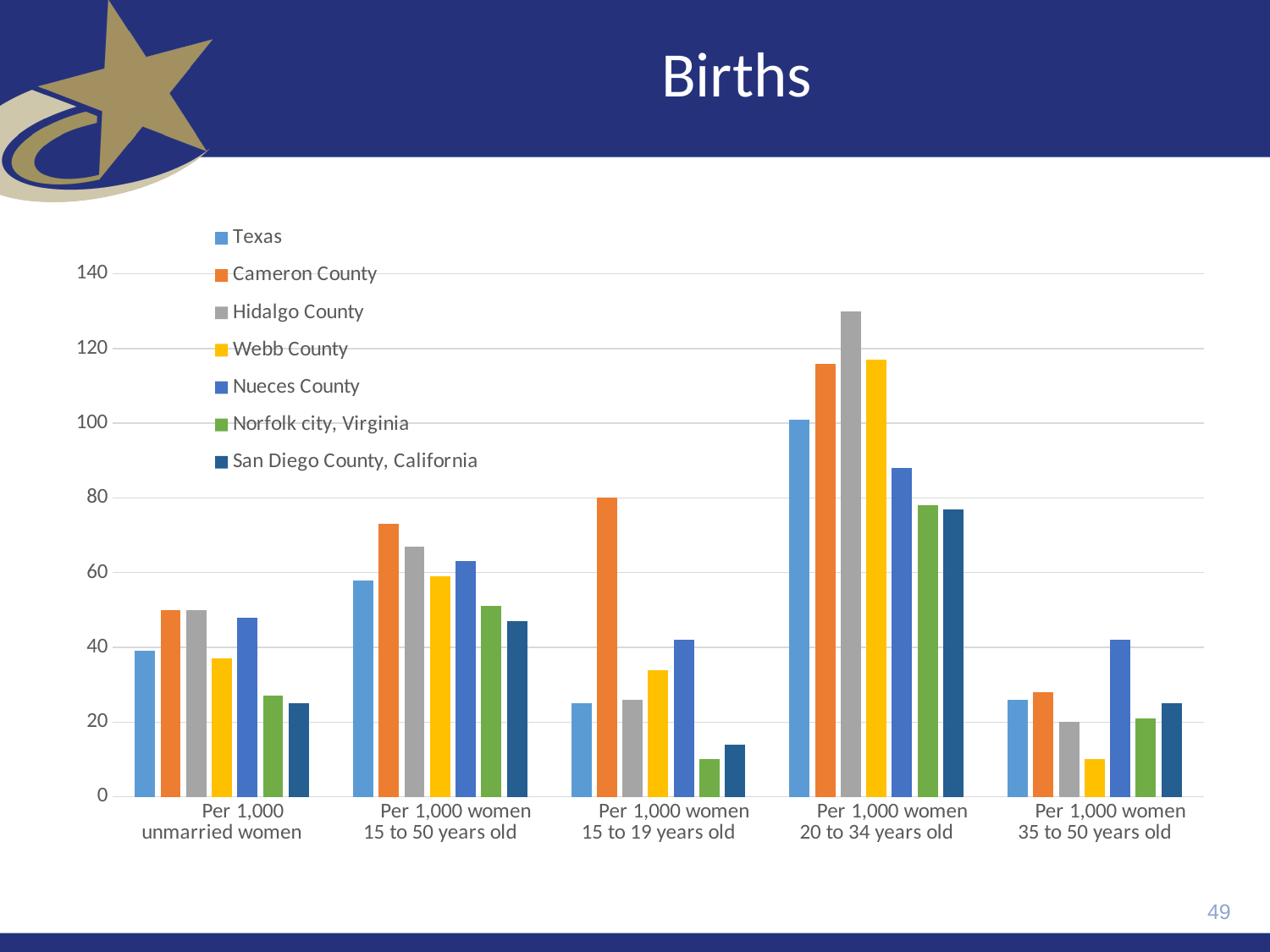
Which series has the highest value for 'Per 1,000 women 35 to 50 years old'? Nueces County Is the value for Cameron County in 'Per 1,000 women 15 to 19 years old' greater or less than 60? greater For 'Per 1,000 women 15 to 50 years old', which is larger: Cameron County or Texas? Cameron County Which series has the lowest value for 'Per 1,000 women 15 to 19 years old'? Norfolk city, Virginia How many series does the legend list? 7 What kind of chart is shown on the slide? bar chart Which series has the highest value for 'Per 1,000 women 20 to 34 years old'? Hidalgo County Is the value for Webb County in 'Per 1,000 women 35 to 50 years old' greater or less than 20? less How many categories are shown along the x axis? 5 What is the title of the slide containing the chart? Births Is the value for Hidalgo County in 'Per 1,000 women 20 to 34 years old' greater or less than 120? greater Which series has the highest value for 'Per 1,000 women 15 to 19 years old'? Cameron County